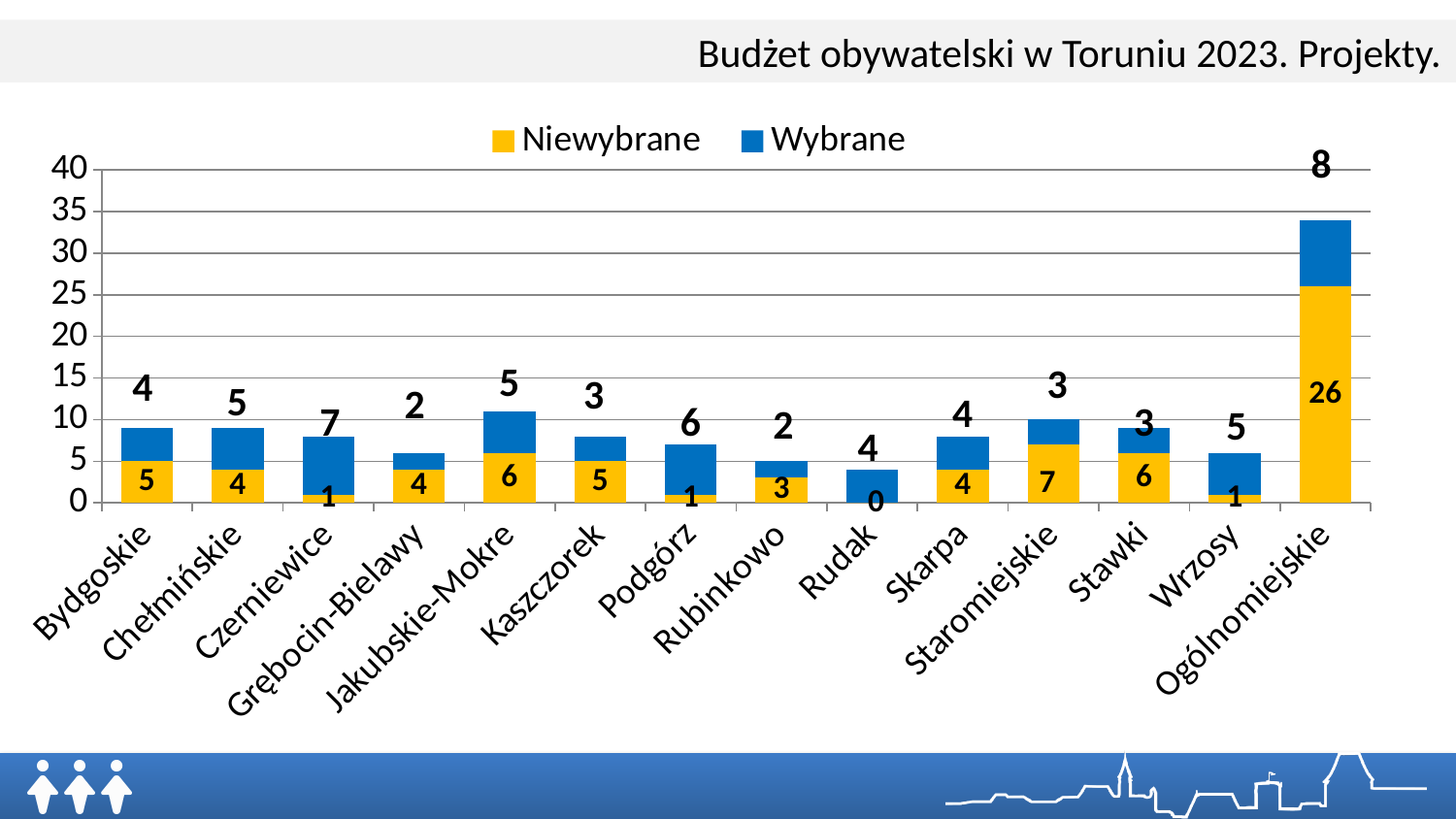
What is the total of the stacked bar for Jakubskie-Mokre? 11 What is the difference between the Niewybrane values for Staromiejskie and Wrzosy? 6 What is the Niewybrane value for Ogólnomiejskie? 26 What kind of chart is shown on the slide? Stacked bar chart Which is larger: the Wybrane value for Podgórz or the Wybrane value for Kaszczorek? Podgórz Which category has the lowest Wybrane value? Grębocin-Bielawy and Rubinkowo (2 each) What is the total of the stacked bar for Ogólnomiejskie? 34 What is the Niewybrane value for Rudak? 0 What is the Wybrane value for Czerniewice? 7 How many series does the legend list? 2 Which category has the highest Niewybrane value? Ogólnomiejskie How many categories are shown on the x axis? 14